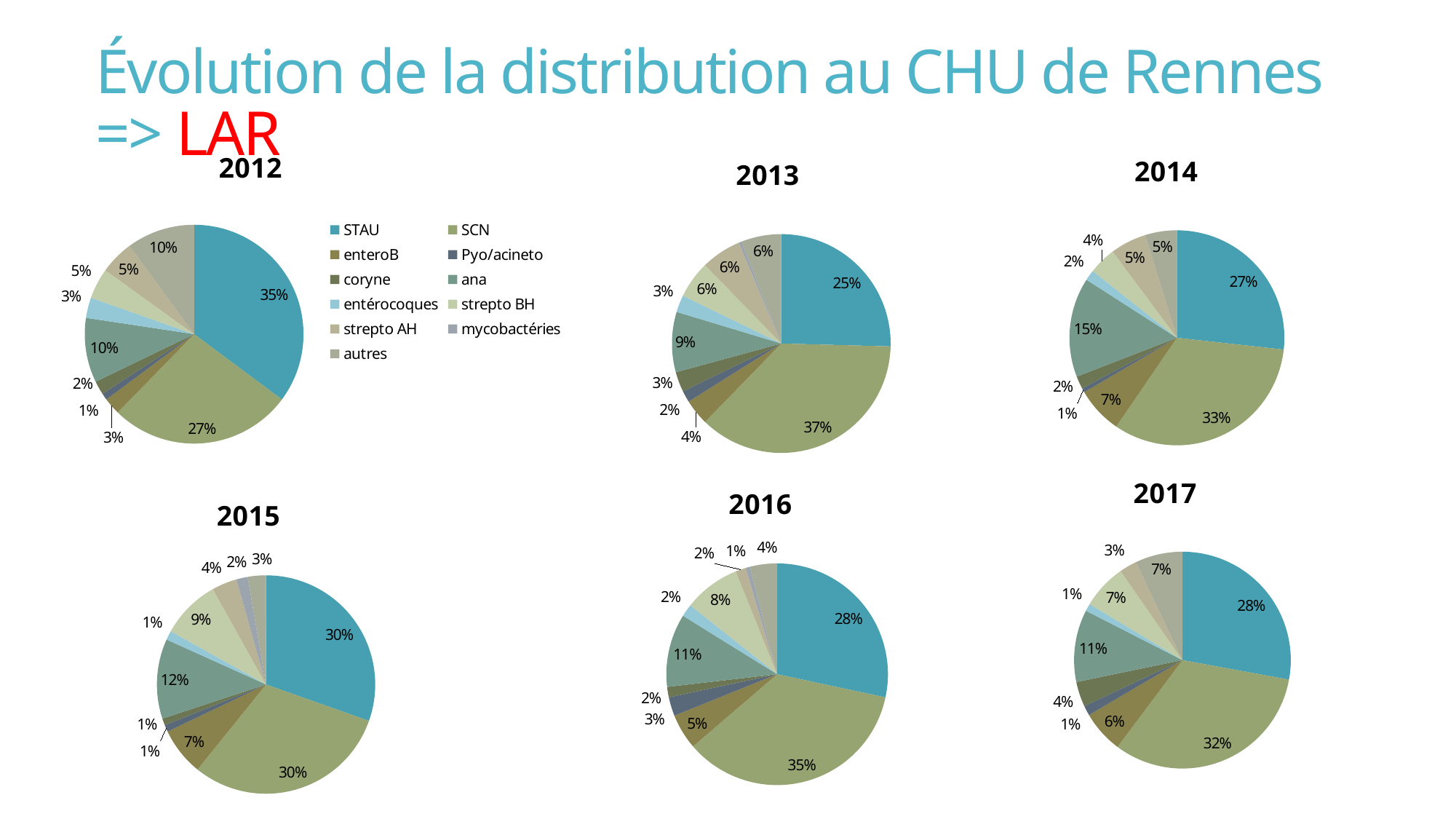
What is the title of the slide? Évolution de la distribution au CHU de Rennes => LAR In the 2012 pie chart, what share does STAU have? 35% What kind of charts are shown on the slide? Pie charts In the 2013 pie chart, what is the share of SCN? 37% How many pie charts are on the slide? 6 In the 2013 pie chart, what is the difference in percentage points between SCN and STAU? 12 In the 2017 pie chart, what is the share of SCN? 32% In the 2016 pie chart, which is larger, STAU or SCN? SCN How many categories does the legend list? 11 In the 2014 pie chart, what share does ana have? 15% Did the share of STAU rise or fall from the 2012 pie chart to the 2013 pie chart? Fall In the 2013 pie chart, which category has the largest share? SCN